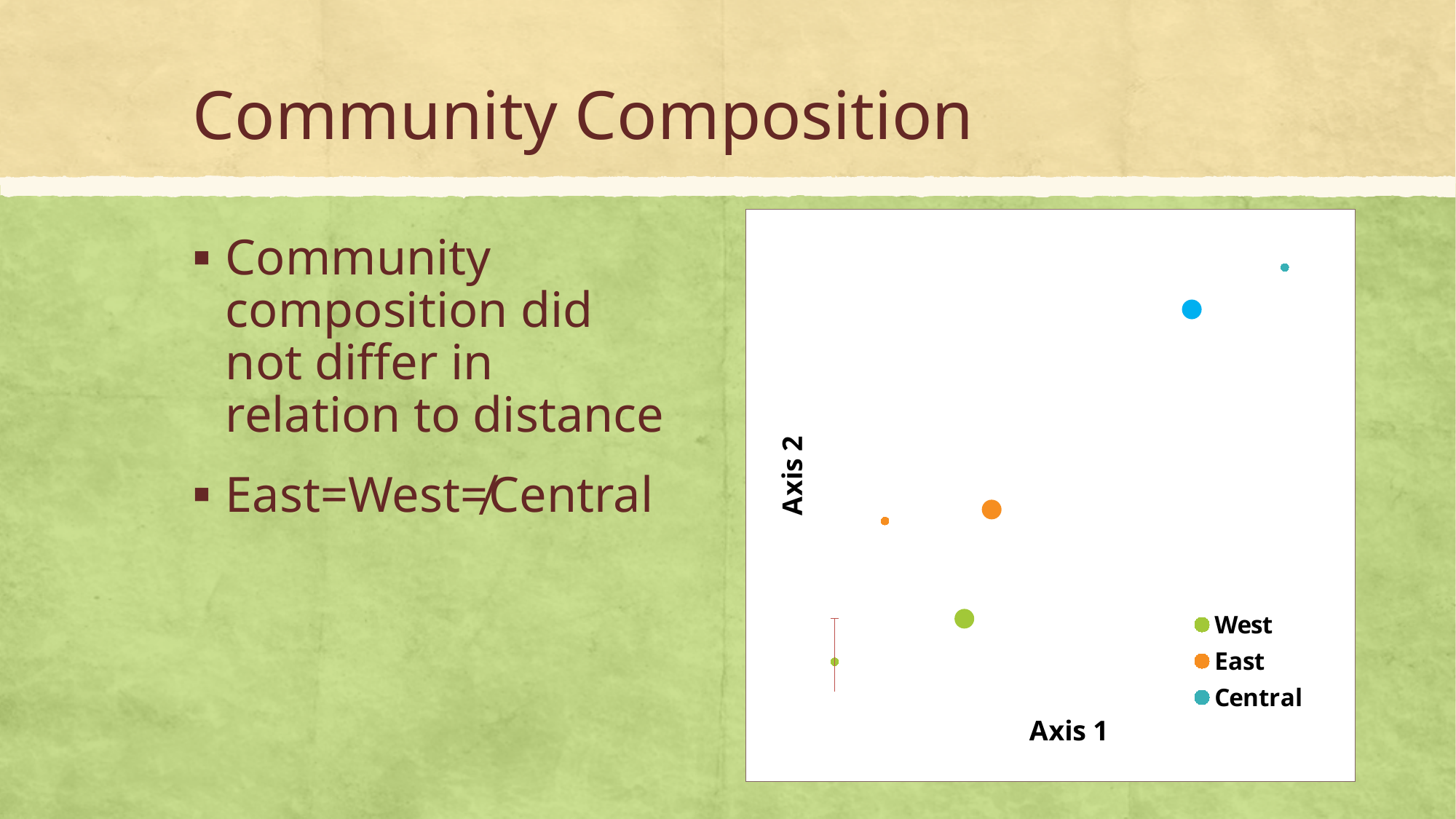
What kind of chart is shown on the slide? scatter chart Which series has the points positioned highest on Axis 2? Central What are the series names listed in the chart's legend? West, East, Central Which series is positioned higher on Axis 2, East or West? East How many points are plotted in total on the chart? 6 Which series has the points positioned lowest on Axis 2? West Which series is positioned further right on Axis 1, Central or West? Central Which series is positioned furthest left on Axis 1? West What is the title of the horizontal axis of the chart? Axis 1 What is the title of the vertical axis of the chart? Axis 2 How many series does the chart's legend list? 3 How many points are plotted for the Central series? 2